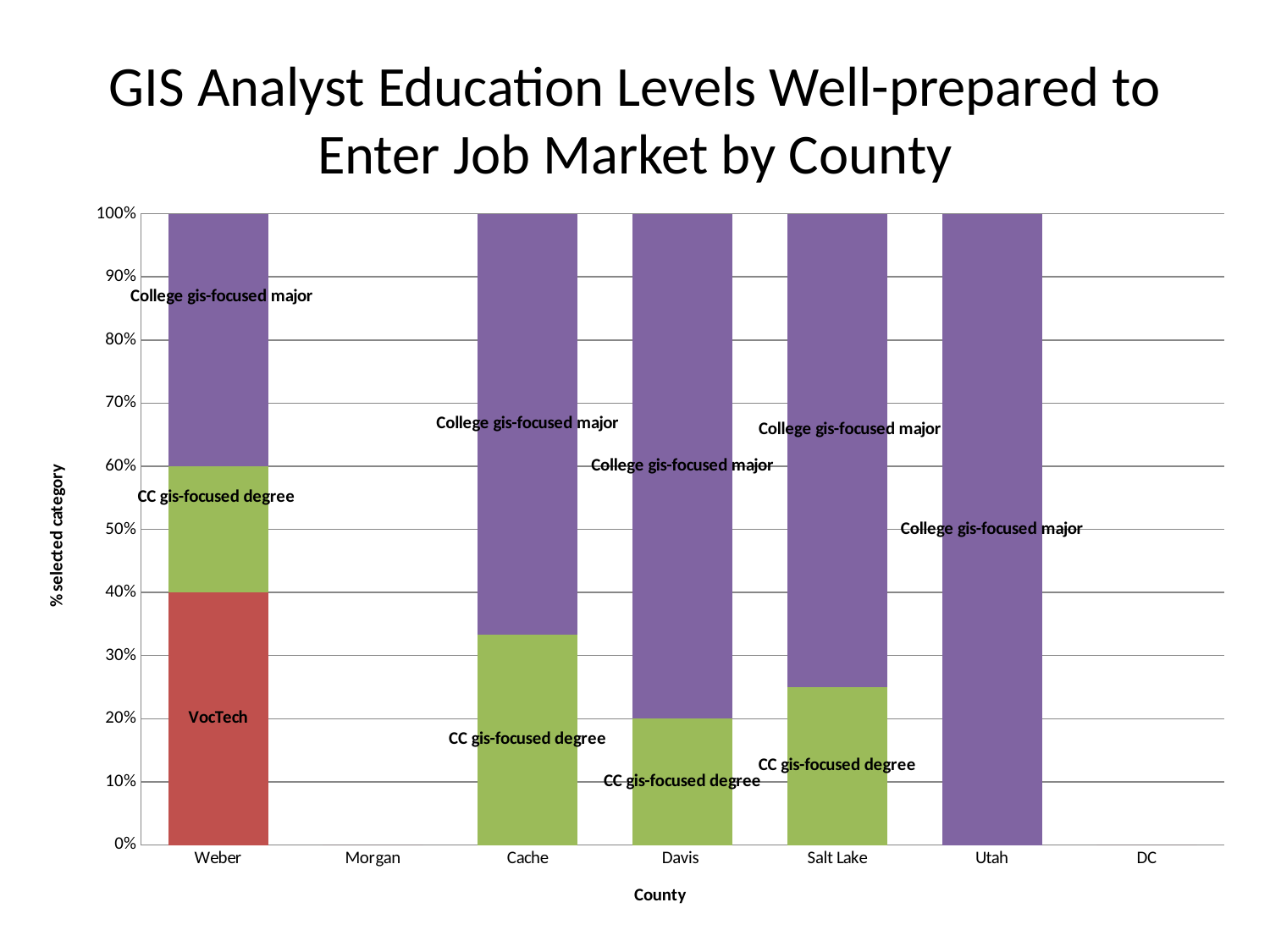
Is the CC gis-focused degree share for Salt Lake greater or less than 30%? less How many counties are listed along the x axis? 7 Which county has the largest College gis-focused major share? Utah What kind of chart is shown on the slide? Stacked bar chart What is the VocTech share for Weber? 40% Which counties on the x axis have no bar plotted? Morgan and DC What is the College gis-focused major share for Weber? 40% Is the CC gis-focused degree share for Cache greater or less than 30%? greater Which county has the larger CC gis-focused degree share, Cache or Davis? Cache Which county is the only one with a VocTech segment? Weber What is the CC gis-focused degree share for Davis? 20% What is the College gis-focused major share for Utah? 100%